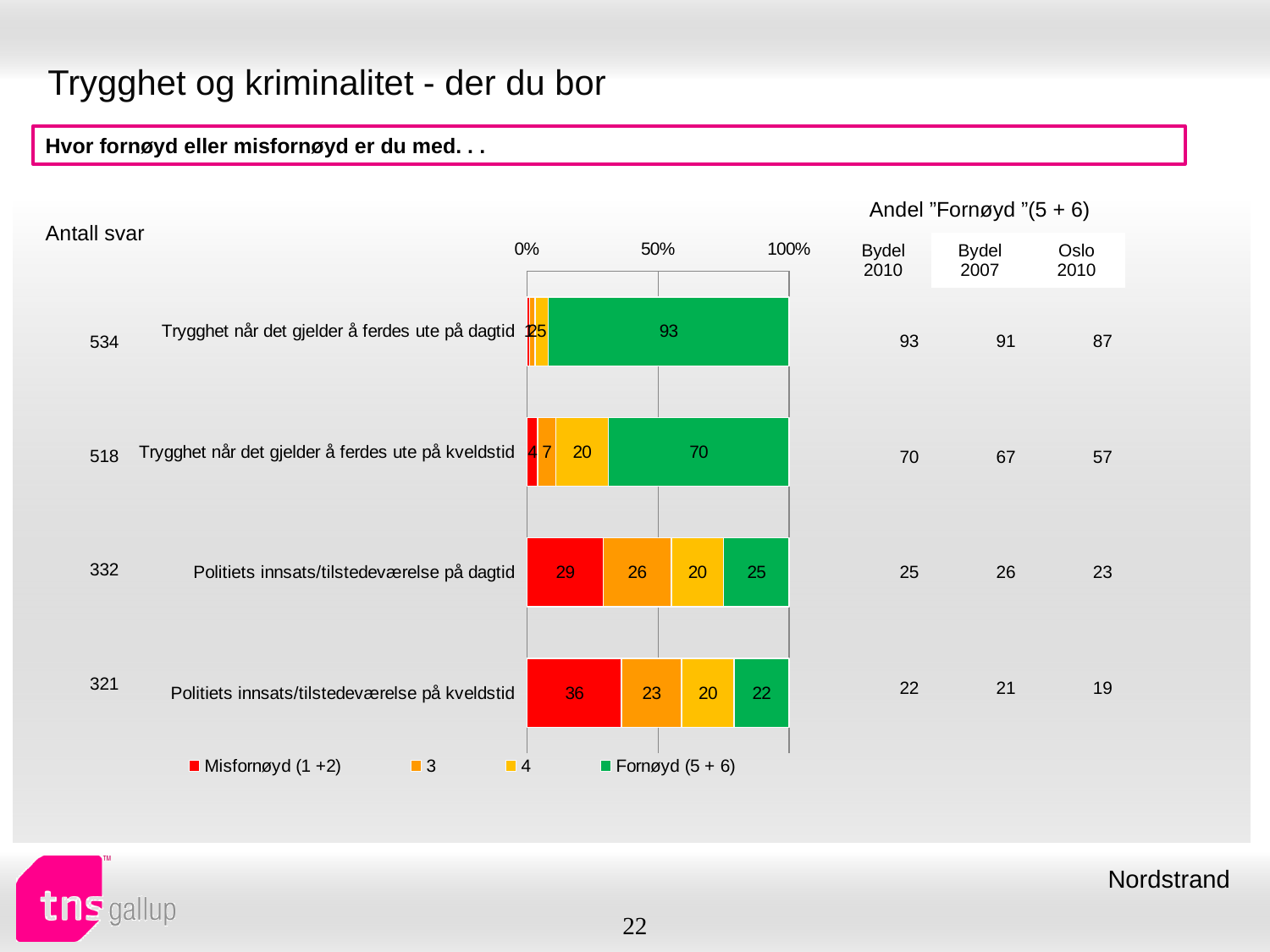
What is the value of the "4" segment for "Trygghet når det gjelder å ferdes ute på kveldstid"? 20 How many categories are shown in the chart? 4 Which category has the lowest "Fornøyd (5 + 6)" value? Politiets innsats/tilstedeværelse på kveldstid What kind of chart is shown on the slide? Stacked bar chart Which is larger: the "Misfornøyd (1 +2)" value for "Politiets innsats/tilstedeværelse på dagtid" or for "Politiets innsats/tilstedeværelse på kveldstid"? Politiets innsats/tilstedeværelse på kveldstid Which category has the highest "Fornøyd (5 + 6)" value? Trygghet når det gjelder å ferdes ute på dagtid How many series does the legend list? 4 What is the value of the "Misfornøyd (1 +2)" segment for "Politiets innsats/tilstedeværelse på kveldstid"? 36 What is the value of the "Fornøyd (5 + 6)" segment for "Trygghet når det gjelder å ferdes ute på dagtid"? 93 What is the value of the "3" segment for "Politiets innsats/tilstedeværelse på dagtid"? 26 What is the difference between the "Fornøyd (5 + 6)" values for "Trygghet når det gjelder å ferdes ute på dagtid" and "Trygghet når det gjelder å ferdes ute på kveldstid"? 23 What is the total of the stacked bar for "Politiets innsats/tilstedeværelse på dagtid"? 100